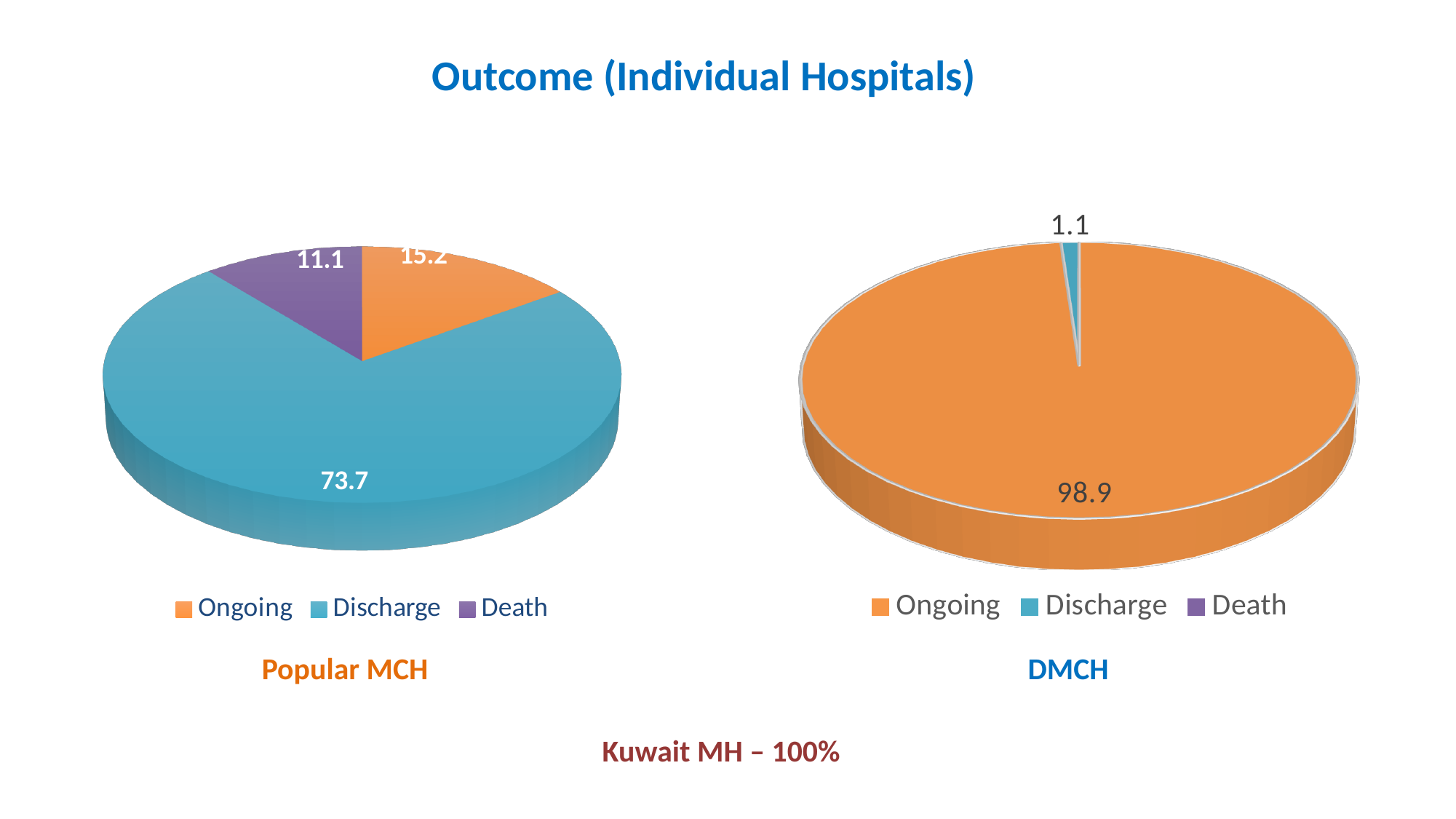
In the DMCH pie chart, what is the value for Ongoing? 98.9 In the DMCH pie chart, what is the value for Discharge? 1.1 In the Popular MCH pie chart, which category has the largest slice? Discharge In the Popular MCH pie chart, what is the difference between the Discharge and Ongoing values? 58.5 What type of chart is used for Popular MCH and DMCH? Pie chart How many entries does the legend of the DMCH chart list? 3 In the Popular MCH pie chart, what is the value for Death? 11.1 In the Popular MCH pie chart, which category has the smallest slice? Death In the DMCH pie chart, which category has the largest slice? Ongoing In the Popular MCH pie chart, what is the value for Discharge? 73.7 In the Popular MCH pie chart, which is larger, Ongoing or Death? Ongoing In the Popular MCH pie chart, what is the value for Ongoing? 15.2